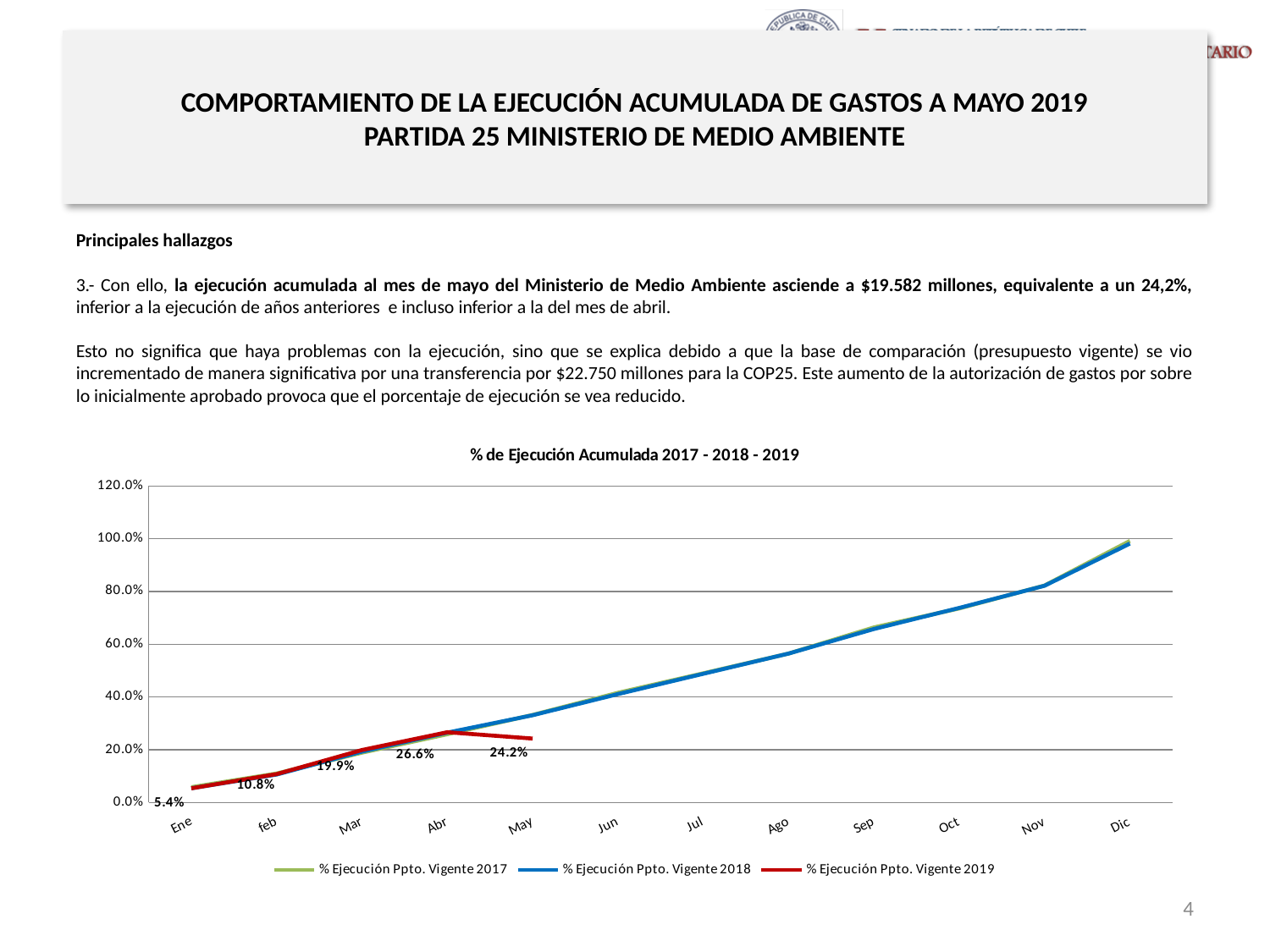
What is the value of % Ejecución Ppto. Vigente 2019 for Ene? 5.4% By how many percentage points does the 2019 value for Abr exceed the 2019 value for May? 2.4 percentage points How many series does the chart legend list? 3 In which month is the % Ejecución Ppto. Vigente 2019 series at its lowest value? Ene How many months are shown on the x axis of the chart? 12 Is the value for % Ejecución Ppto. Vigente 2018 in Dic greater or less than 80.0%? greater In which month does the % Ejecución Ppto. Vigente 2019 series reach its highest value? Abr What is the value of % Ejecución Ppto. Vigente 2019 for Abr? 26.6% Is the value for % Ejecución Ppto. Vigente 2018 in Jun greater or less than 60.0%? less What type of chart is shown on the slide? Line chart Which is larger for the 2019 series: the value for Mar or the value for feb? Mar What is the value of % Ejecución Ppto. Vigente 2019 for May? 24.2%